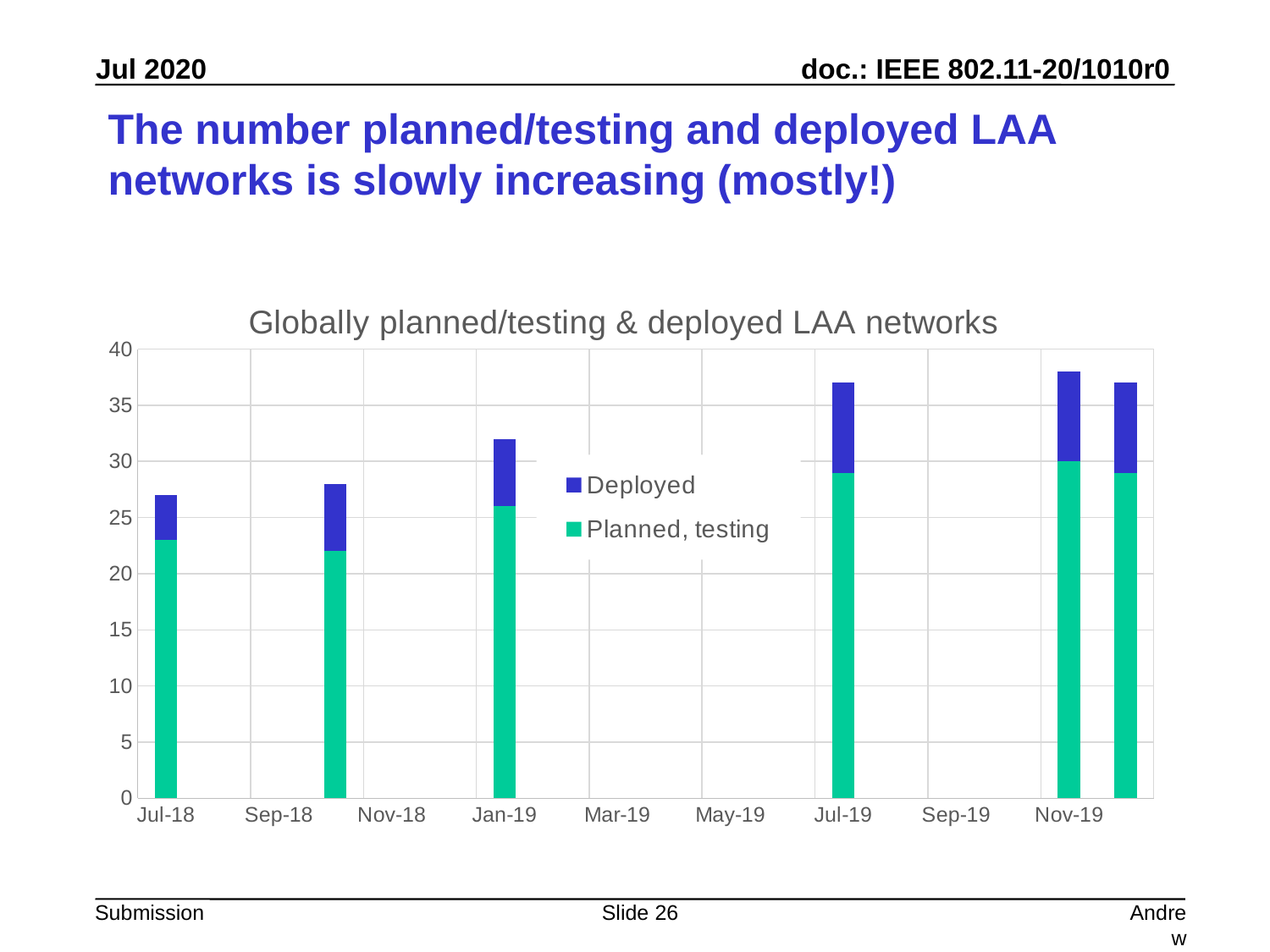
What kind of chart is shown on the slide? Stacked bar chart Do the total bar heights generally rise or fall from Jul-18 to the end of 2019? rise How many bars are plotted in the chart? 6 Is the total height of the Jul-19 bar greater or less than 35? greater Is the Planned, testing value for Nov-19 greater or less than 25? greater How many series does the legend list? 2 Is the Planned, testing value for Jul-18 greater or less than 20? greater Which colour represents the Deployed series? Blue What is the title of the chart? Globally planned/testing & deployed LAA networks